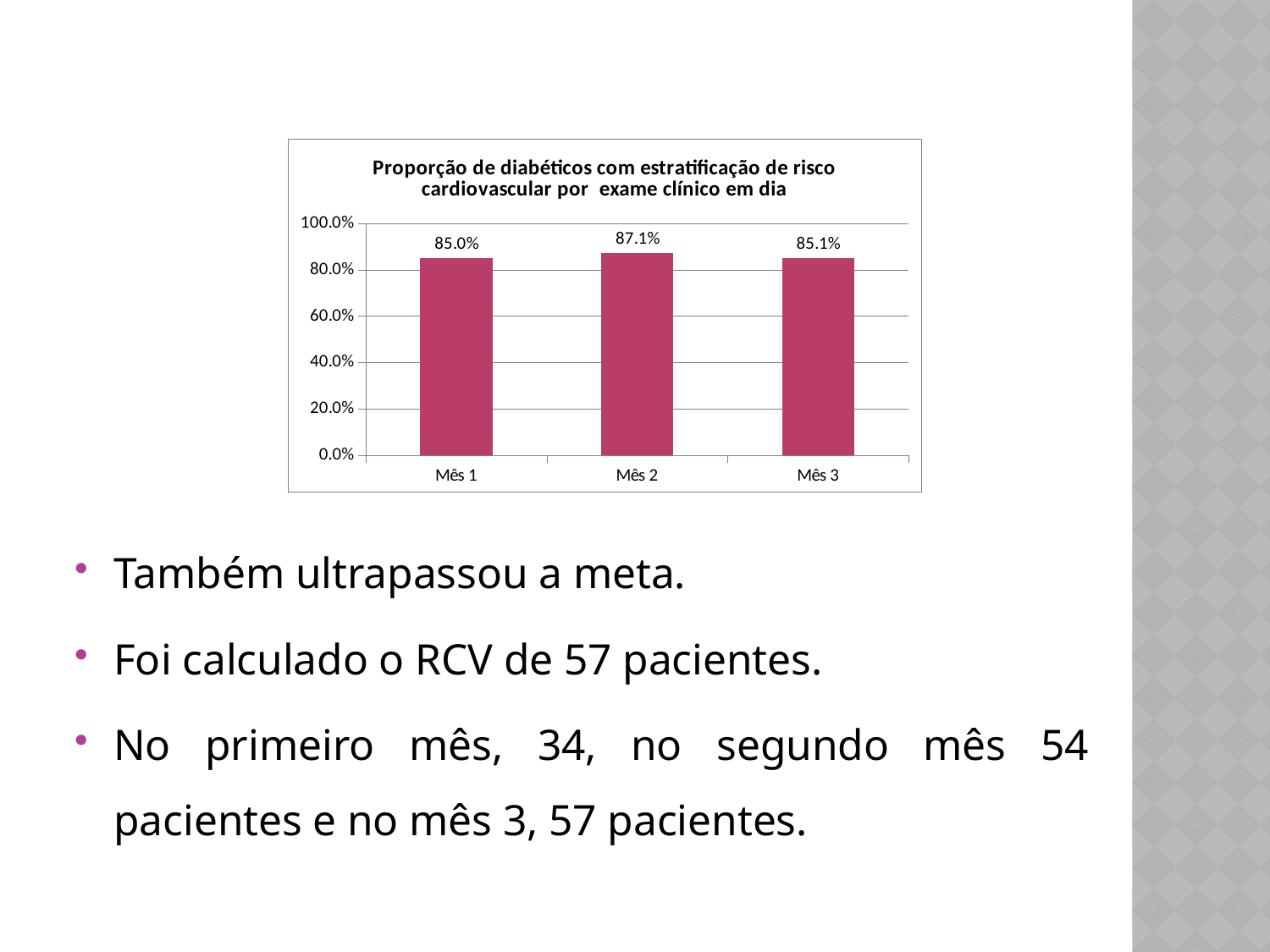
Which month has the highest value? Mês 2 Does the value rise or fall from Mês 1 to Mês 2? Rise How many categories are shown on the x axis? 3 Which is larger, the value for Mês 2 or the value for Mês 1? Mês 2 Is the value for Mês 1 greater or less than 80.0%? greater What is the difference between the values for Mês 2 and Mês 3? 2.0 percentage points What kind of chart is shown on the slide? Bar chart What is the value for Mês 1? 85.0% What is the difference between the values for Mês 2 and Mês 1? 2.1 percentage points What is the value for Mês 2? 87.1% Is the value for Mês 2 greater or less than 100.0%? less What is the value for Mês 3? 85.1%